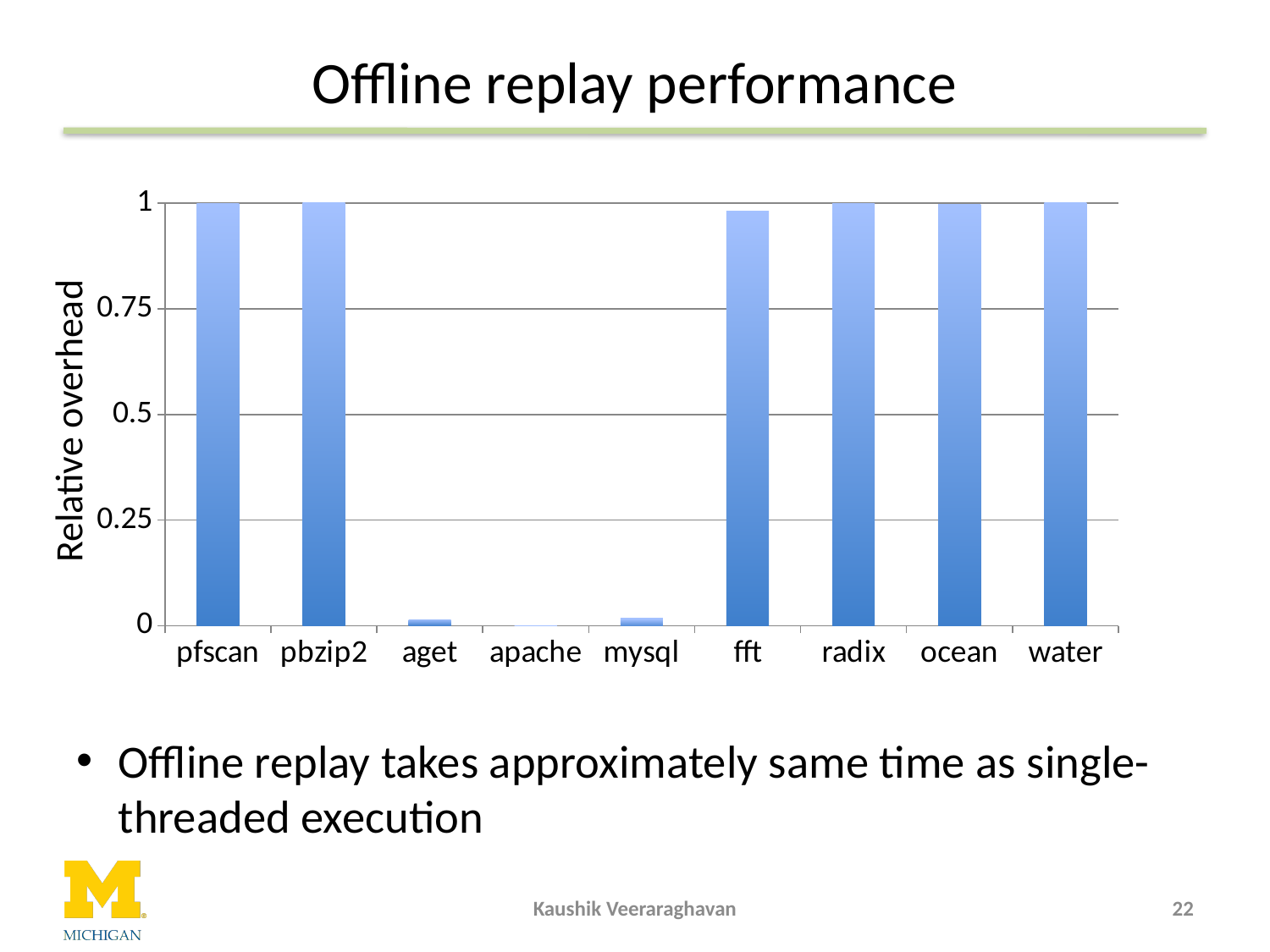
Is the value for fft greater or less than 0.75? greater Is the value for pfscan greater or less than 0.75? greater Which has the larger value, mysql or radix? radix Which has the larger value, apache or water? water Is the value for aget greater or less than 0.25? less How many categories are shown on the x axis of the chart? 9 Which has the larger value, pbzip2 or aget? pbzip2 What is the title of the chart on the slide? Offline replay performance What is the label of the y axis of the chart? Relative overhead What kind of chart is shown on the slide? bar chart